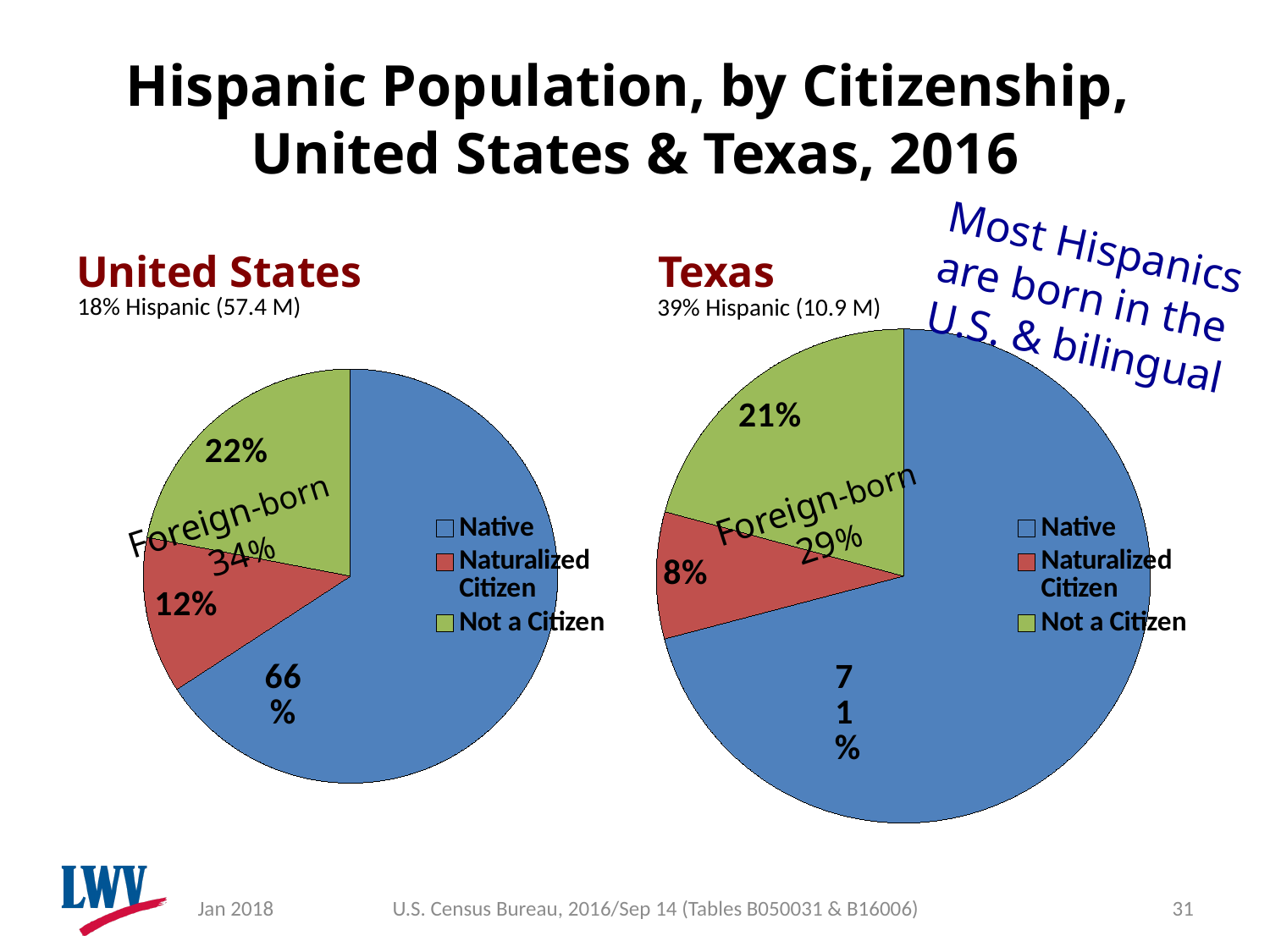
In the United States pie chart, what is the difference between the Not a Citizen share and the Naturalized Citizen share? 10% In the Texas pie chart, what percentage of the Hispanic population is Native? 71% In the United States pie chart, what share is labelled for Naturalized Citizen? 12% In the Texas pie chart, what share is labelled for Not a Citizen? 21% How many categories does the legend of the Texas pie chart list? 3 In the United States pie chart, which category has the largest slice? Native What type of chart is used for the United States data? Pie chart In the Texas pie chart, what colour is the Not a Citizen slice? Green In the United States pie chart, what percentage is labelled as Foreign-born? 34% Which pie chart shows a larger Native share, United States or Texas? Texas In the United States pie chart, what percentage of the Hispanic population is Native? 66% In the Texas pie chart, which category has the smallest slice? Naturalized Citizen